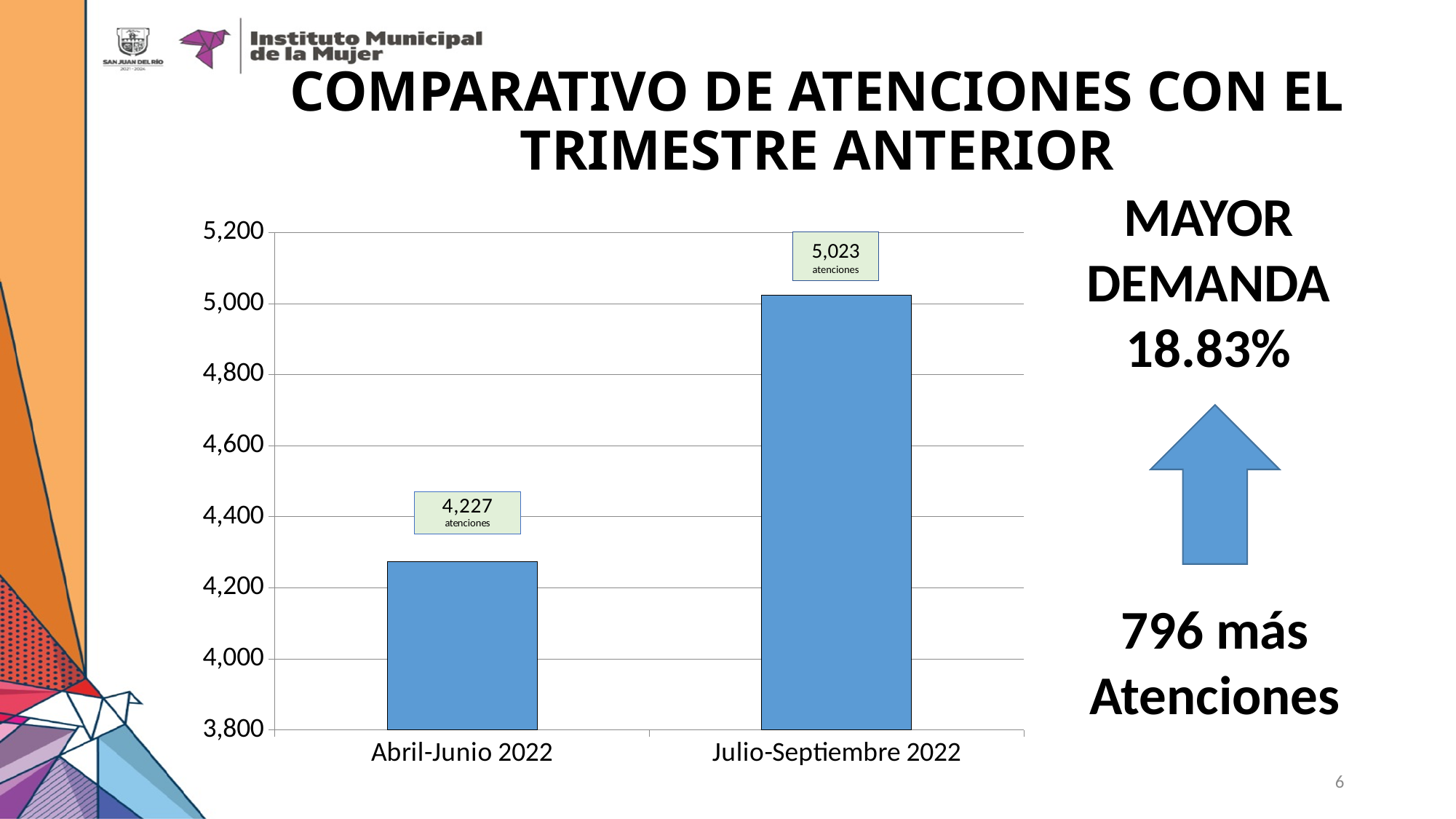
What is the value for Julio-Septiembre 2022? 5,023 Do the values rise or fall from Abril-Junio 2022 to Julio-Septiembre 2022? rise Which period has the lowest value? Abril-Junio 2022 Which is larger, the value for Abril-Junio 2022 or the value for Julio-Septiembre 2022? Julio-Septiembre 2022 Is the value for Abril-Junio 2022 greater or less than 4,400? less Is the value for Julio-Septiembre 2022 greater or less than 5,000? greater What is the value for Abril-Junio 2022? 4,227 What is the title of the slide containing the chart? COMPARATIVO DE ATENCIONES CON EL TRIMESTRE ANTERIOR What is the difference between the values for Julio-Septiembre 2022 and Abril-Junio 2022? 796 What kind of chart is shown on the slide? bar chart Which period has the highest value? Julio-Septiembre 2022 How many categories are shown on the x axis? 2